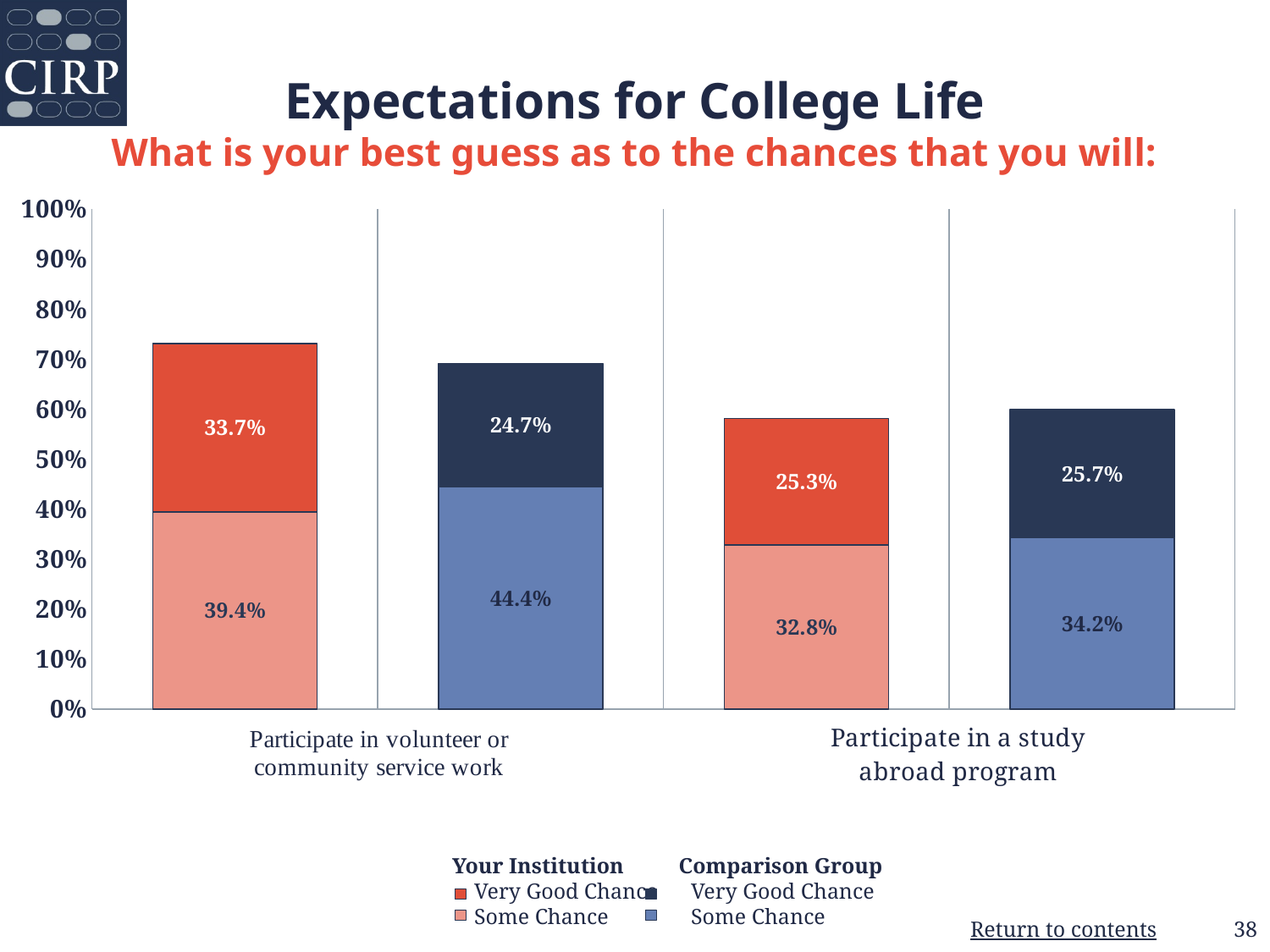
What is the 'Very Good Chance' value for the Comparison Group for 'Participate in a study abroad program'? 25.7% What is the total stacked value for Your Institution's bar for 'Participate in volunteer or community service work'? 73.1% How many entries does the chart legend list? 4 How many categories are shown on the x axis of the chart? 2 Which 'Some Chance' segment has the lowest value on the chart? Your Institution, Participate in a study abroad program (32.8%) What is the 'Very Good Chance' value for Your Institution for 'Participate in volunteer or community service work'? 33.7% Which is larger for 'Participate in volunteer or community service work': the 'Very Good Chance' value for Your Institution or for the Comparison Group? Your Institution What is the difference between the 'Some Chance' values for the Comparison Group and Your Institution for 'Participate in volunteer or community service work'? 5.0% What type of chart is shown on the slide? Stacked bar chart What is the 'Some Chance' value for the Comparison Group for 'Participate in volunteer or community service work'? 44.4% What is the 'Some Chance' value for Your Institution for 'Participate in a study abroad program'? 32.8% What is the total stacked value for the Comparison Group's bar for 'Participate in a study abroad program'? 59.9%